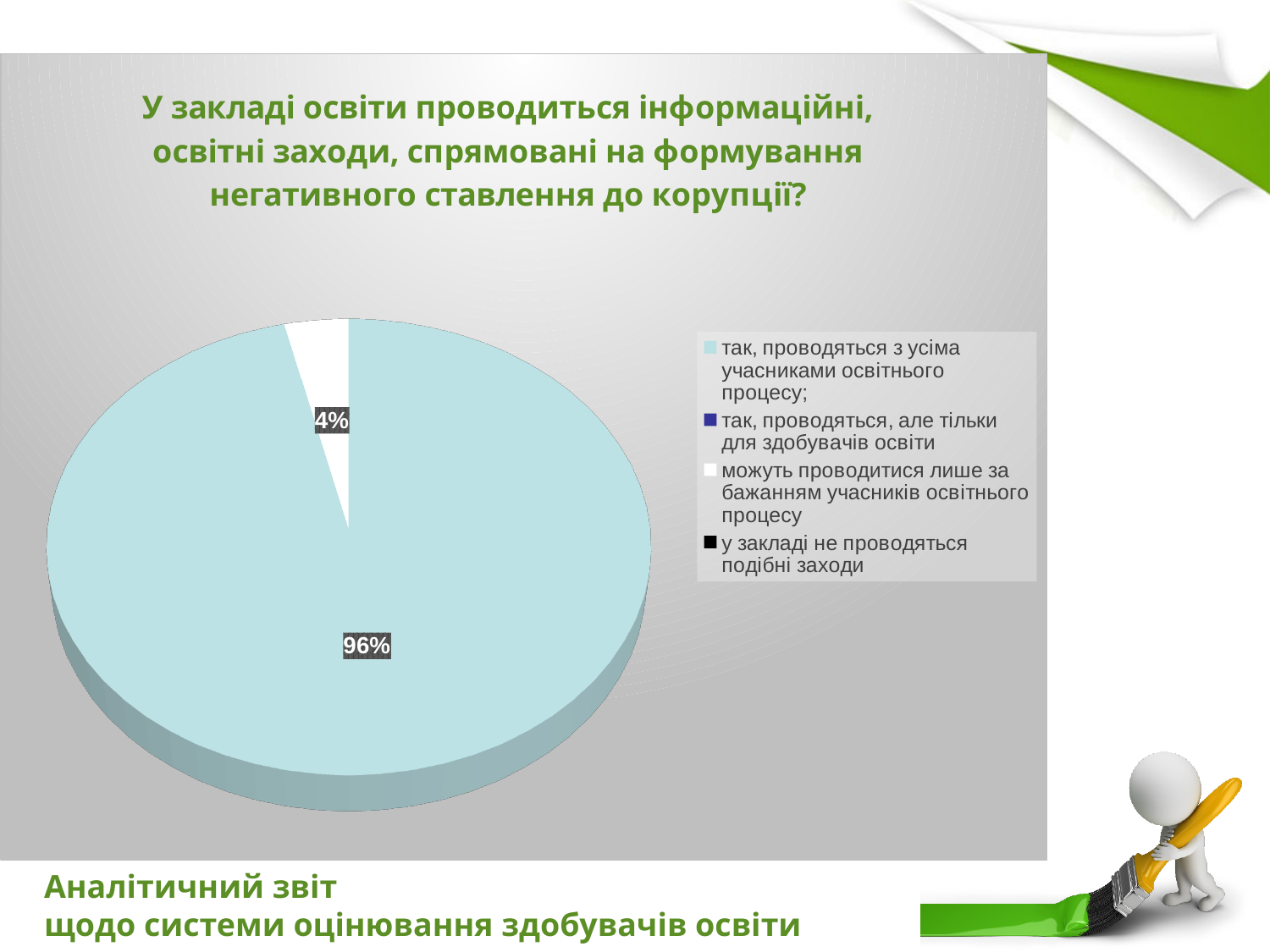
What is the difference in percentage points between the 96% slice and the 4% slice? 92 What share of the pie is labelled for "так, проводяться з усіма учасниками освітнього процесу"? 96% How many entries does the legend list? 4 What is the title of the chart? У закладі освіти проводиться інформаційні, освітні заходи, спрямовані на формування негативного ставлення до корупції? Is the share for "так, проводяться з усіма учасниками освітнього процесу" greater or less than 50%? greater What colour is the slice representing "так, проводяться з усіма учасниками освітнього процесу"? light blue Which legend category has the largest slice of the pie? так, проводяться з усіма учасниками освітнього процесу How many slices have a percentage label printed on the pie? 2 What is the total of the two labelled slices, 96% and 4%? 100% What share of the pie is labelled for "можуть проводитися лише за бажанням учасників освітнього процесу"? 4% Which of the two labelled slices is smaller, the light blue one or the white one? the white one What kind of chart is shown on the slide? pie chart